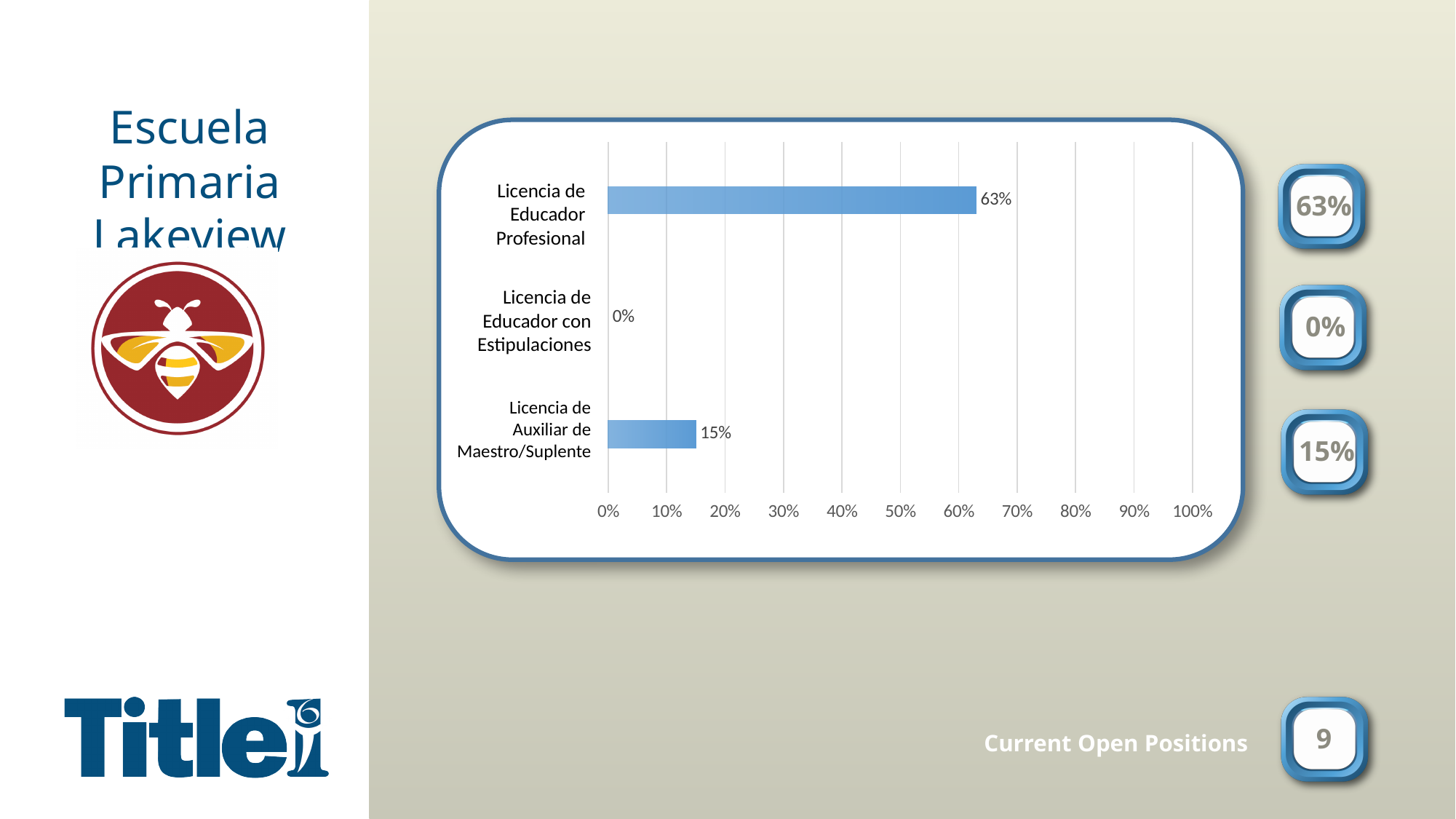
Is the value for Licencia de Auxiliar de Maestro/Suplente greater or less than 20%? less What is the value for Licencia de Educador Profesional? 63% What is the value for Licencia de Auxiliar de Maestro/Suplente? 15% What is the maximum value shown on the horizontal axis of the chart? 100% Which category has the highest value? Licencia de Educador Profesional Which category has the lowest value? Licencia de Educador con Estipulaciones What kind of chart is shown on the slide? Bar chart Which is larger, the value for Licencia de Educador Profesional or the value for Licencia de Auxiliar de Maestro/Suplente? Licencia de Educador Profesional Is the value for Licencia de Educador Profesional greater or less than 50%? greater What is the value for Licencia de Educador con Estipulaciones? 0% What is the difference between the values for Licencia de Educador Profesional and Licencia de Auxiliar de Maestro/Suplente? 48% How many categories are shown in the chart? 3